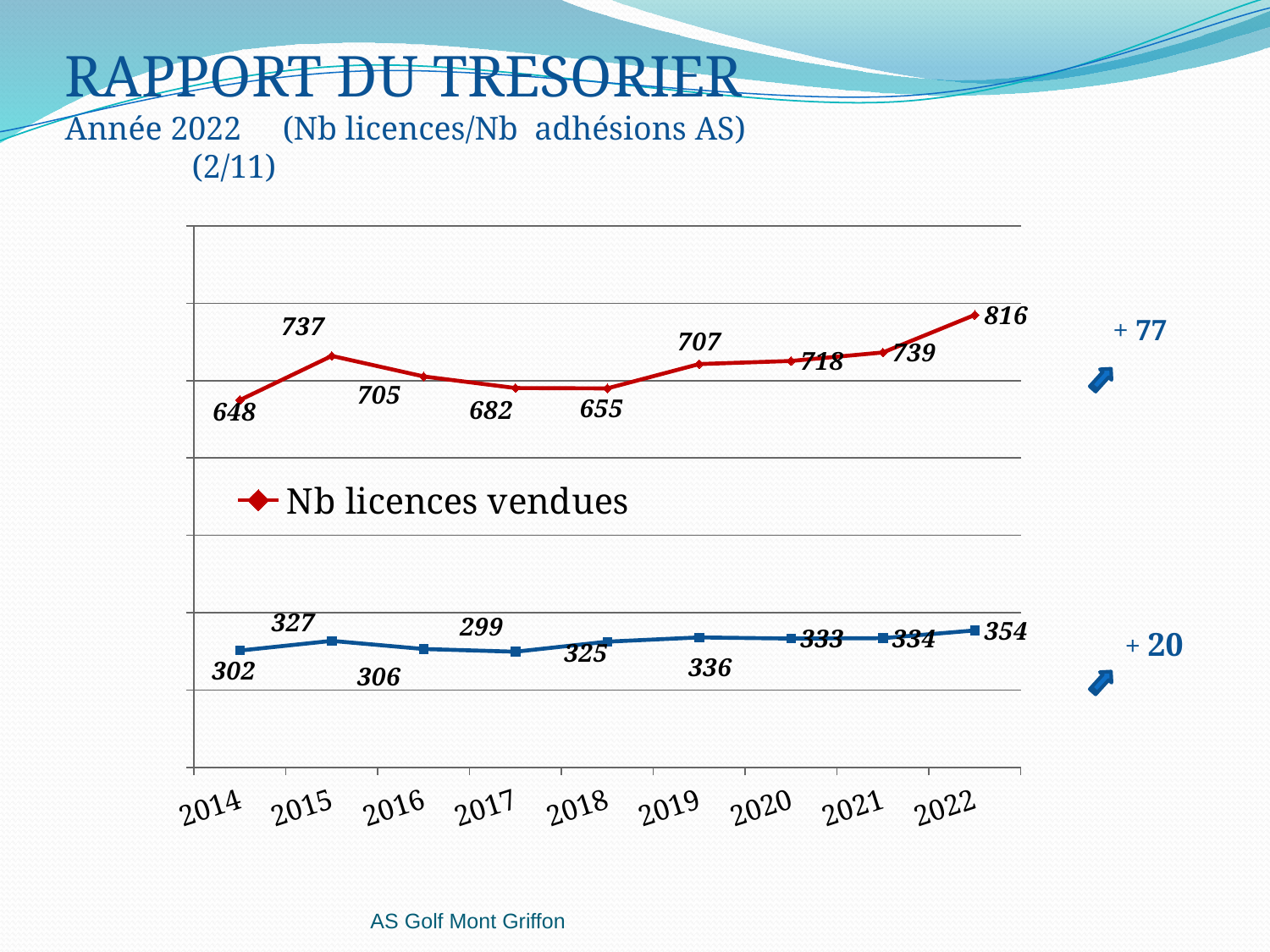
What is the difference between the blue (lower) line's value in 2022 and in 2021? 20 What is the value of Nb licences vendues in 2022? 816 What is the value of Nb licences vendues in 2018? 655 In which year is Nb licences vendues highest? 2022 What type of chart is shown on the slide? line chart How many years are shown on the x axis? 9 Which series name appears in the chart legend? Nb licences vendues In which year is Nb licences vendues lowest? 2014 In which year is the blue (lower) line at its lowest value? 2017 Which is larger for Nb licences vendues: the value in 2015 or the value in 2019? 2015 What is the difference between Nb licences vendues in 2022 and in 2021? 77 What is the value of the blue (lower) line in 2017? 299